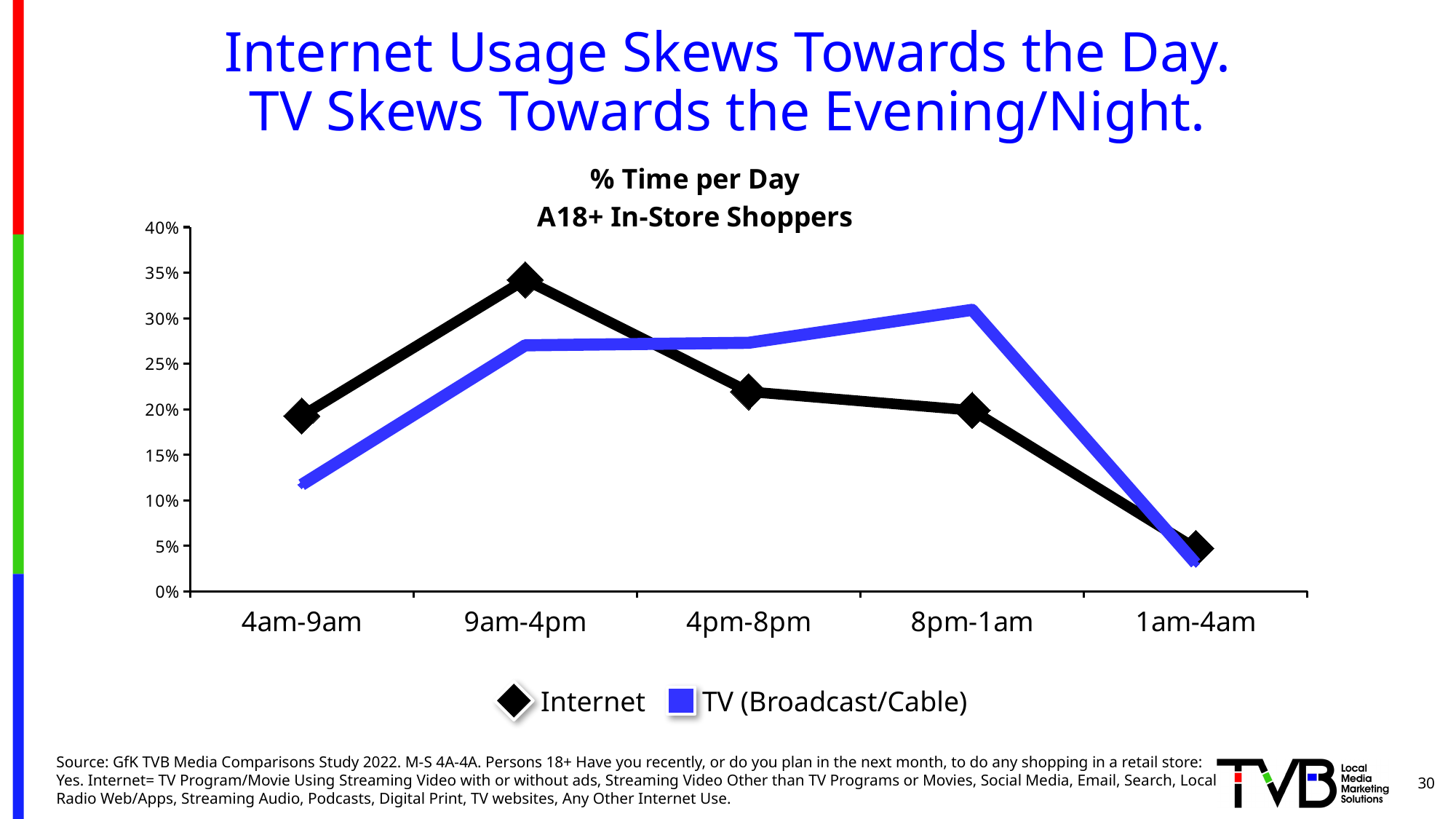
How many series does the legend list? 2 In which time period is the Internet value highest? 9am-4pm How many time periods are shown on the x axis? 5 In which time period is the Internet value lowest? 1am-4am Does the Internet line rise or fall from 9am-4pm to 1am-4am? fall Is the TV (Broadcast/Cable) value for 4am-9am greater or less than 15%? less Is the Internet value for 9am-4pm greater or less than 30%? greater Which series has the larger value for 4am-9am, Internet or TV (Broadcast/Cable)? Internet What kind of chart is shown on the slide? line chart In which time period is the TV (Broadcast/Cable) value highest? 8pm-1am What is the title of the chart? % Time per Day A18+ In-Store Shoppers Which series has the larger value for 8pm-1am, Internet or TV (Broadcast/Cable)? TV (Broadcast/Cable)